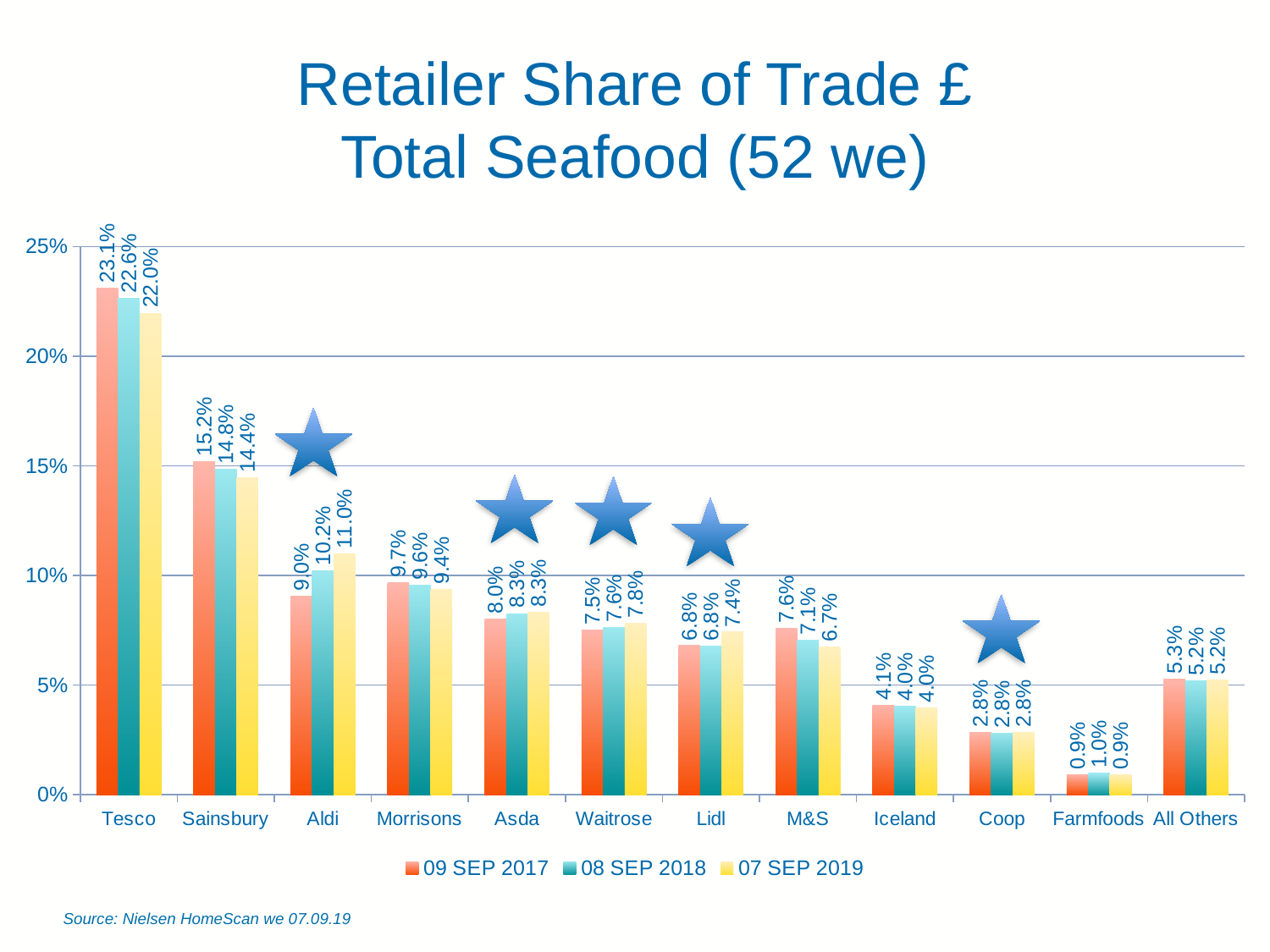
How many series does the legend list? 3 Is Sainsbury's share for 09 SEP 2017 greater or less than 15%? greater Which is larger: Aldi's share in 07 SEP 2019 or Morrisons' share in 07 SEP 2019? Aldi What kind of chart is shown on the slide? Bar chart What is Aldi's share of trade for 08 SEP 2018? 10.2% Does Aldi's share of trade rise or fall from 09 SEP 2017 to 07 SEP 2019? Rise Which retailer has the lowest share of trade in 08 SEP 2018? Farmfoods What is Tesco's share of trade for 07 SEP 2019? 22.0% How many retailer categories are shown on the x axis? 12 What is the value for Farmfoods in 09 SEP 2017? 0.9% Which retailer has the highest share of trade in 07 SEP 2019? Tesco What is the difference between Tesco's share in 09 SEP 2017 and 07 SEP 2019? 1.1%